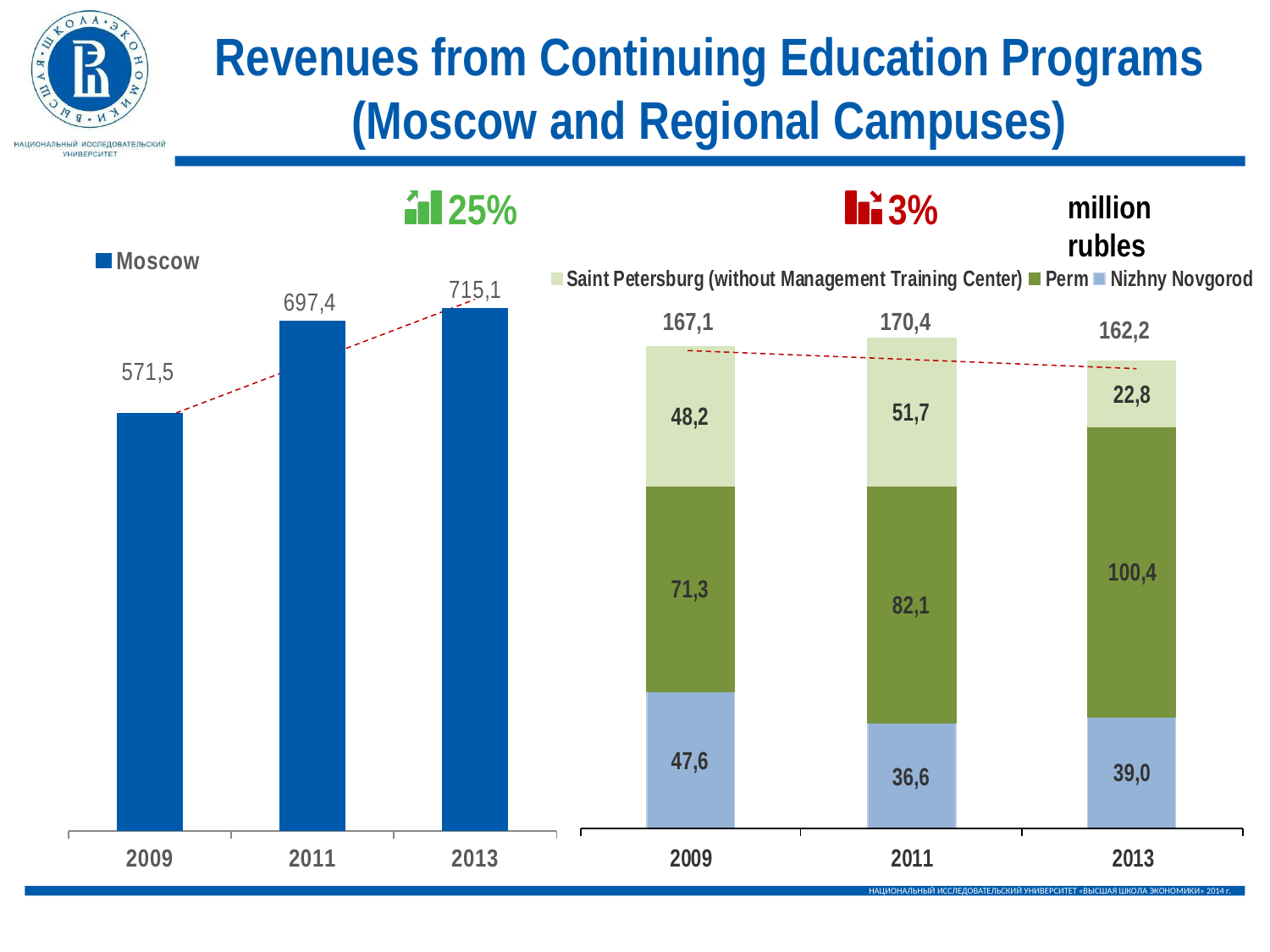
In the right chart (regional campuses), what is the Nizhny Novgorod value for 2011? 36,6 In the left chart (Moscow), what is the revenue value for 2011? 697,4 In the right chart (regional campuses), which is larger in 2009: the Saint Petersburg value or the Nizhny Novgorod value? Saint Petersburg In the left chart (Moscow), which year has the highest value? 2013 In the left chart (Moscow), do the values rise or fall from 2009 to 2013? rise In the left chart (Moscow), what is the difference between the 2013 and 2009 values? 143,6 In the right chart (regional campuses), what is the difference between the Perm values for 2013 and 2011? 18,3 In the left chart (Moscow), which year has the lowest value? 2009 What kind of chart is the right chart (regional campuses)? stacked bar chart In the right chart (regional campuses), what is the total of the stacked bar for 2011? 170,4 In the right chart (regional campuses), what is the Perm value for 2013? 100,4 In the right chart (regional campuses), how many series does the legend list? 3